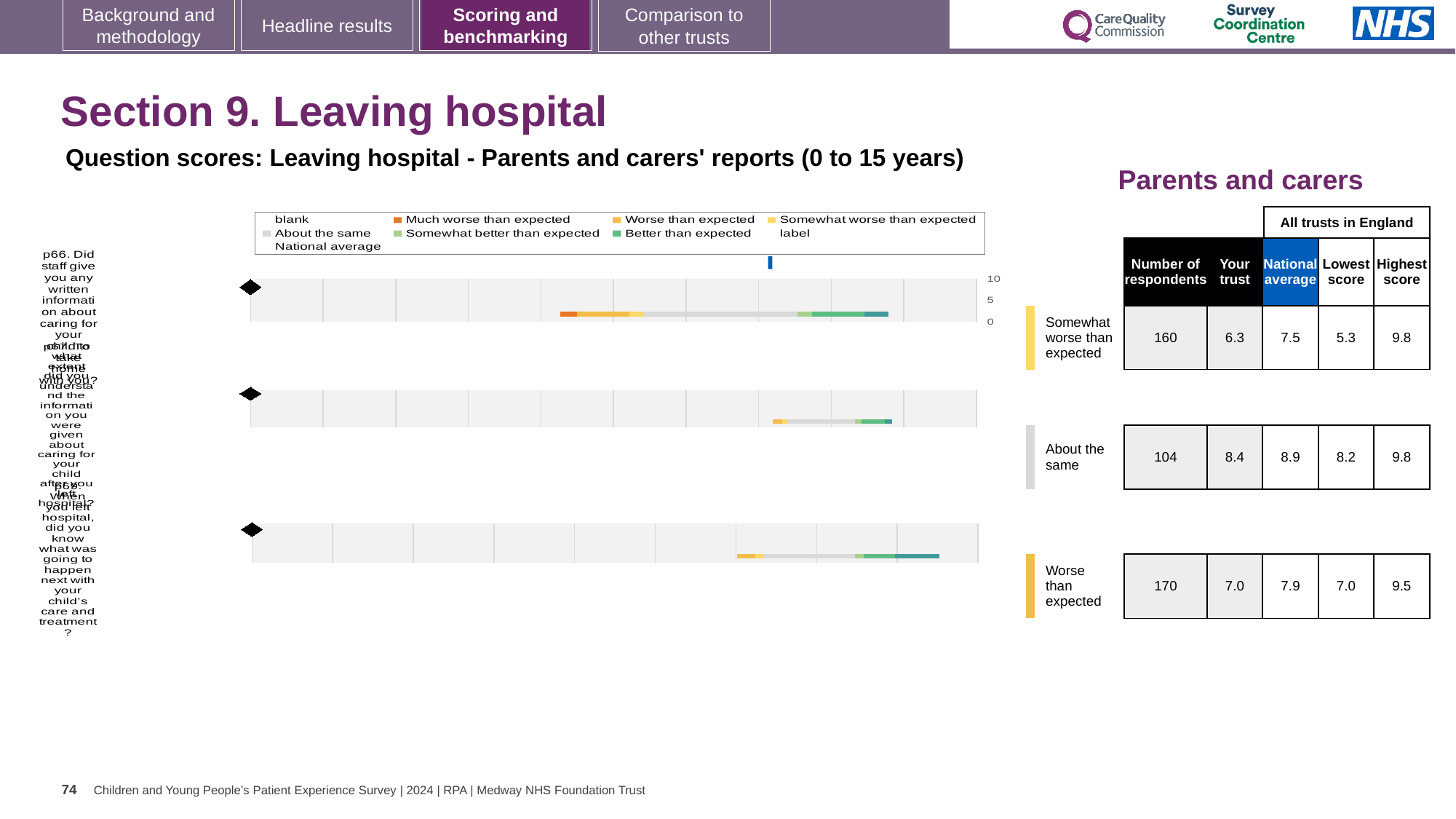
In the chart legend, what colour represents 'Much worse than expected'? orange In the table beside the charts, what is the highest score for the row labelled 'About the same'? 9.8 What is the highest tick value shown on the chart axis? 10 In the table beside the charts, for the row labelled 'About the same', which is larger: the 'Your trust' score or the national average? National average In the table beside the charts, what is the lowest score for the row labelled 'Worse than expected'? 7.0 What kind of chart is used for the three question rows on the slide? bar chart In the table beside the charts, which row has the highest number of respondents? Worse than expected How many separate question charts are shown on the slide? 3 In the table beside the charts, what is the difference between the national average and the 'Your trust' score for the row labelled 'Somewhat worse than expected'? 1.2 In the table beside the charts, what is the 'Your trust' score for the row labelled 'About the same'? 8.4 In the table beside the charts, what is the national average for the row labelled 'Worse than expected'? 7.9 In the table beside the charts, how many respondents are listed for the row labelled 'Somewhat worse than expected'? 160